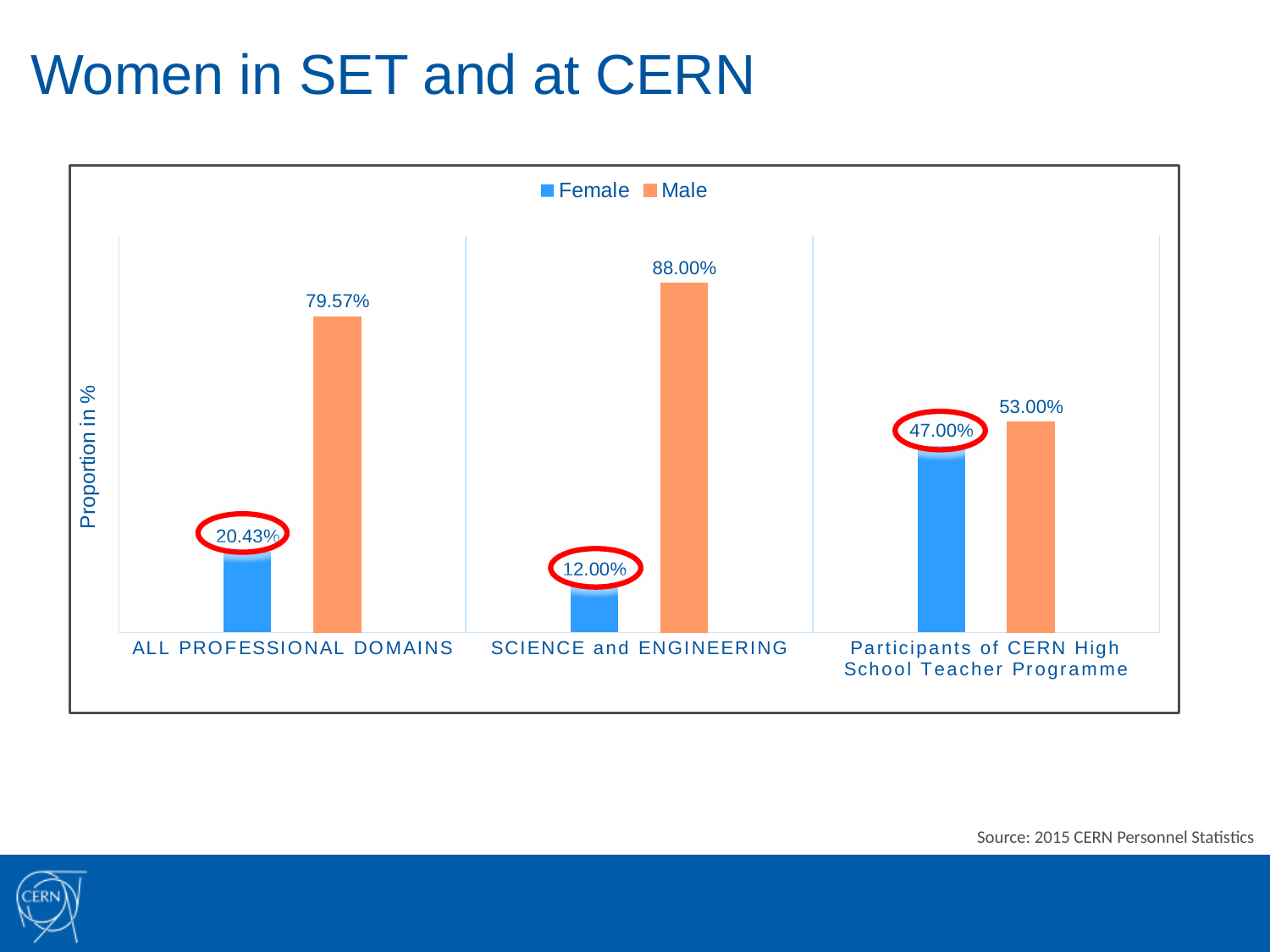
How many series does the legend list? 2 What is the difference between the Male and Female values for ALL PROFESSIONAL DOMAINS? 59.14% What is the Female value for SCIENCE and ENGINEERING? 12.00% What kind of chart is shown on the slide? Bar chart Which category has the highest Male value? SCIENCE and ENGINEERING Which category has the lowest Female value? SCIENCE and ENGINEERING Which is larger for Participants of CERN High School Teacher Programme, the Female value or the Male value? Male What is the Male value for SCIENCE and ENGINEERING? 88.00% How many categories are shown on the x axis? 3 What is the Male value for ALL PROFESSIONAL DOMAINS? 79.57% What is the Female value for Participants of CERN High School Teacher Programme? 47.00% Which category has the highest Female value? Participants of CERN High School Teacher Programme